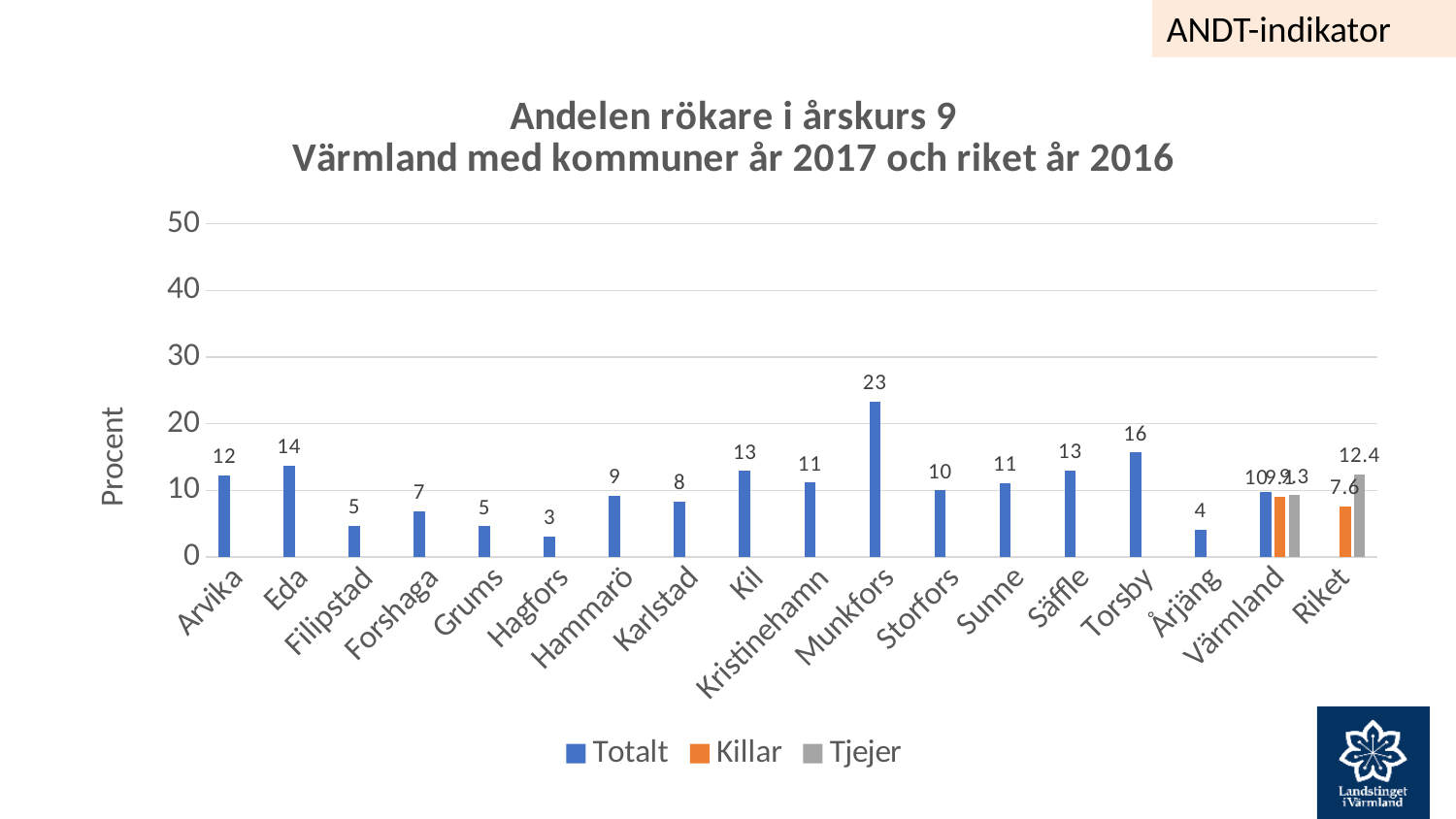
What is the difference between the Totalt values for Munkfors and Torsby? 7 What is the Totalt value for Hagfors? 3 Which municipality has the lowest Totalt value? Hagfors What is the Killar value for Riket? 7.6 What is the Tjejer value for Riket? 12.4 Which municipality has the highest Totalt value? Munkfors What kind of chart is shown on the slide? bar chart What is the Totalt value for Munkfors? 23 How many series does the legend list? 3 Is the Totalt value for Munkfors greater or less than 20? greater How many categories are shown on the x axis? 18 Which has a higher Totalt value, Eda or Arvika? Eda